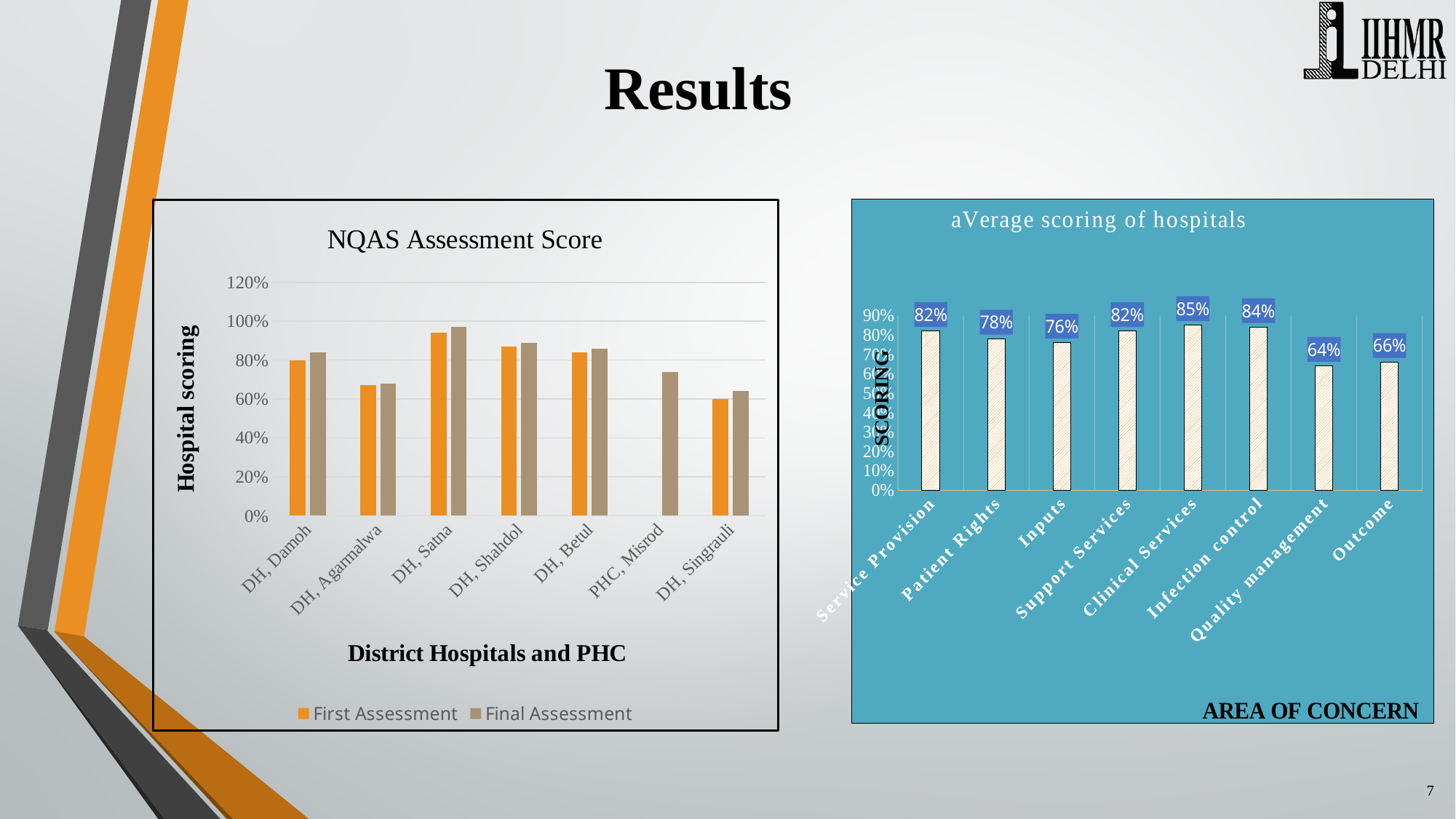
How many hospitals/PHCs are shown on the x axis of the 'NQAS Assessment Score' chart? 7 In the 'aVerage scoring of hospitals' chart, which area of concern has the lowest score? Quality management In the 'aVerage scoring of hospitals' chart, which is larger: the score for Patient Rights or the score for Outcome? Patient Rights How many areas of concern are shown in the 'aVerage scoring of hospitals' chart? 8 In the 'aVerage scoring of hospitals' chart, which area of concern has the highest score? Clinical Services In the 'NQAS Assessment Score' chart, is the Final Assessment value for PHC, Misrod greater or less than 80%? less In the 'aVerage scoring of hospitals' chart, what is the value for Quality management? 64% In the 'NQAS Assessment Score' chart, is the First Assessment value for DH, Satna greater or less than 80%? greater In the 'aVerage scoring of hospitals' chart, what is the difference between the scores for Service Provision and Inputs? 6% How many series does the legend of the 'NQAS Assessment Score' chart list? 2 In the 'aVerage scoring of hospitals' chart, what is the value for Clinical Services? 85% What type of chart is the 'NQAS Assessment Score' chart? Bar chart